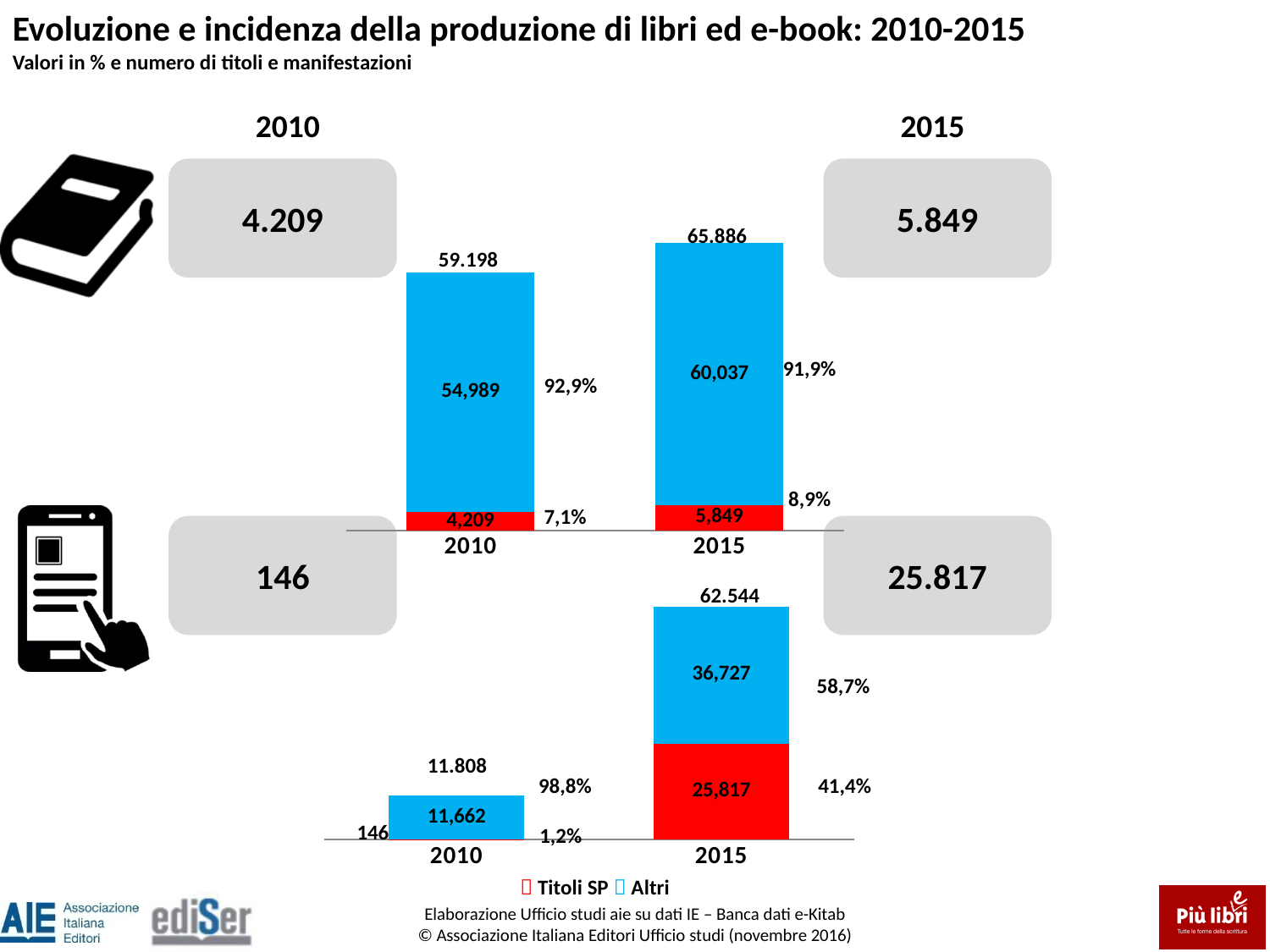
In the top chart (books), what is the difference between the Titoli SP values for 2015 and 2010? 1,640 In the top chart (books), what is the value of Altri for 2015? 60,037 In the bottom chart (e-books), what is the total of the stacked bar for 2010? 11.808 In the bottom chart (e-books), what is the value of Titoli SP for 2015? 25,817 In the bottom chart (e-books), what percentage share does Titoli SP have in 2015? 41,4% In the top chart (books), what is the total of the stacked bar for 2015? 65.886 How many series does the legend list? 2 In the bottom chart (e-books), what is the value of Altri for 2010? 11,662 What kind of chart is used on the slide? Stacked bar chart In the top chart (books), what percentage share does Altri have in 2010? 92,9% In the top chart (books), what is the value of Titoli SP for 2010? 4,209 In the bottom chart (e-books), which year has the larger Titoli SP value, 2010 or 2015? 2015